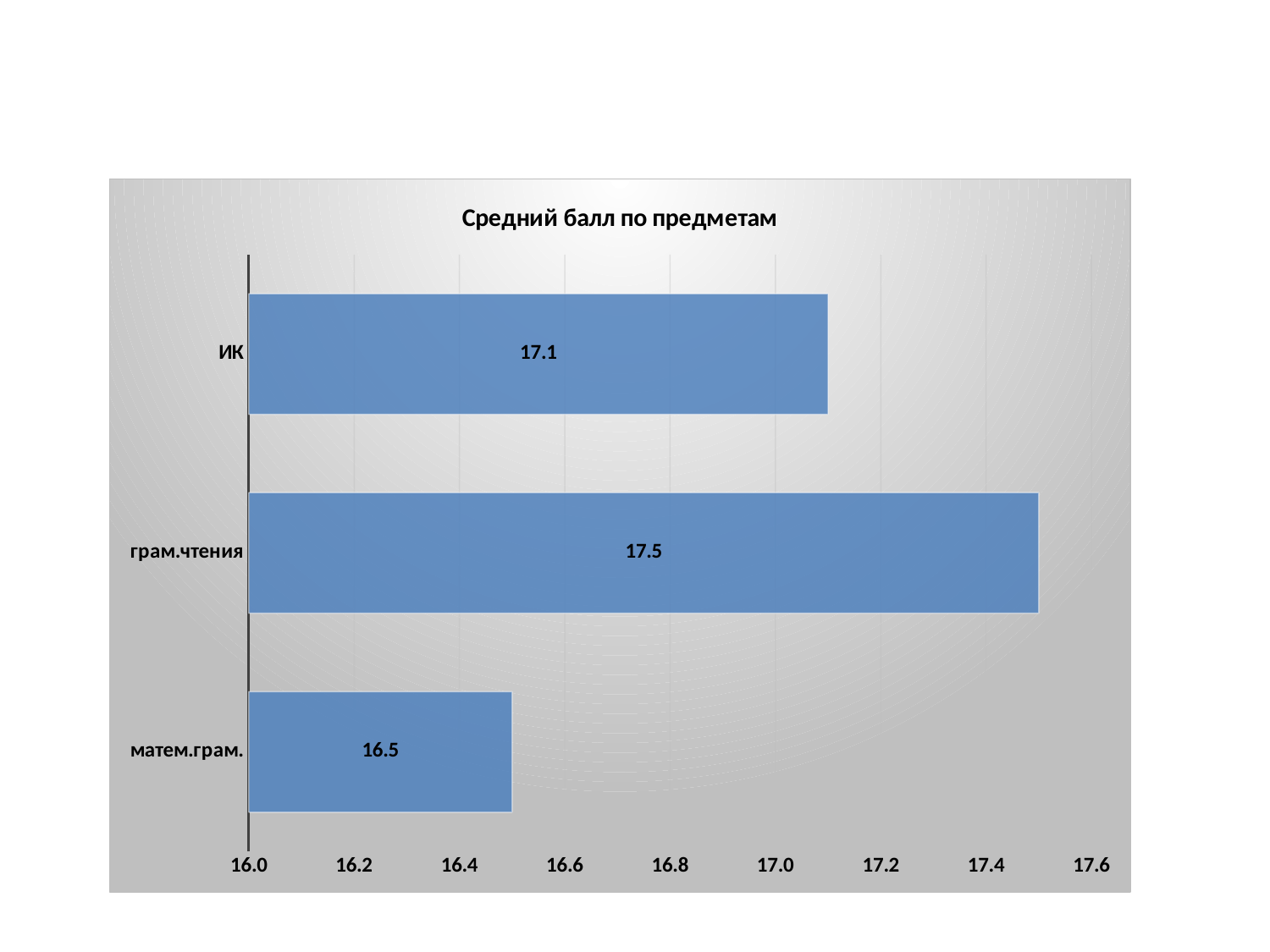
What is the title of the chart? Средний балл по предметам What is the difference between the values for грам.чтения and ИК? 0.4 What is the value for матем.грам.? 16.5 Which is larger, the value for ИК or the value for матем.грам.? ИК How many categories are shown in the chart? 3 Which category has the lowest value? матем.грам. What is the difference between the values for грам.чтения and матем.грам.? 1.0 Is the value for ИК greater or less than 17.0? greater Which category has the highest value? грам.чтения What kind of chart is shown on the slide? bar chart What is the value for грам.чтения? 17.5 What is the value for ИК? 17.1